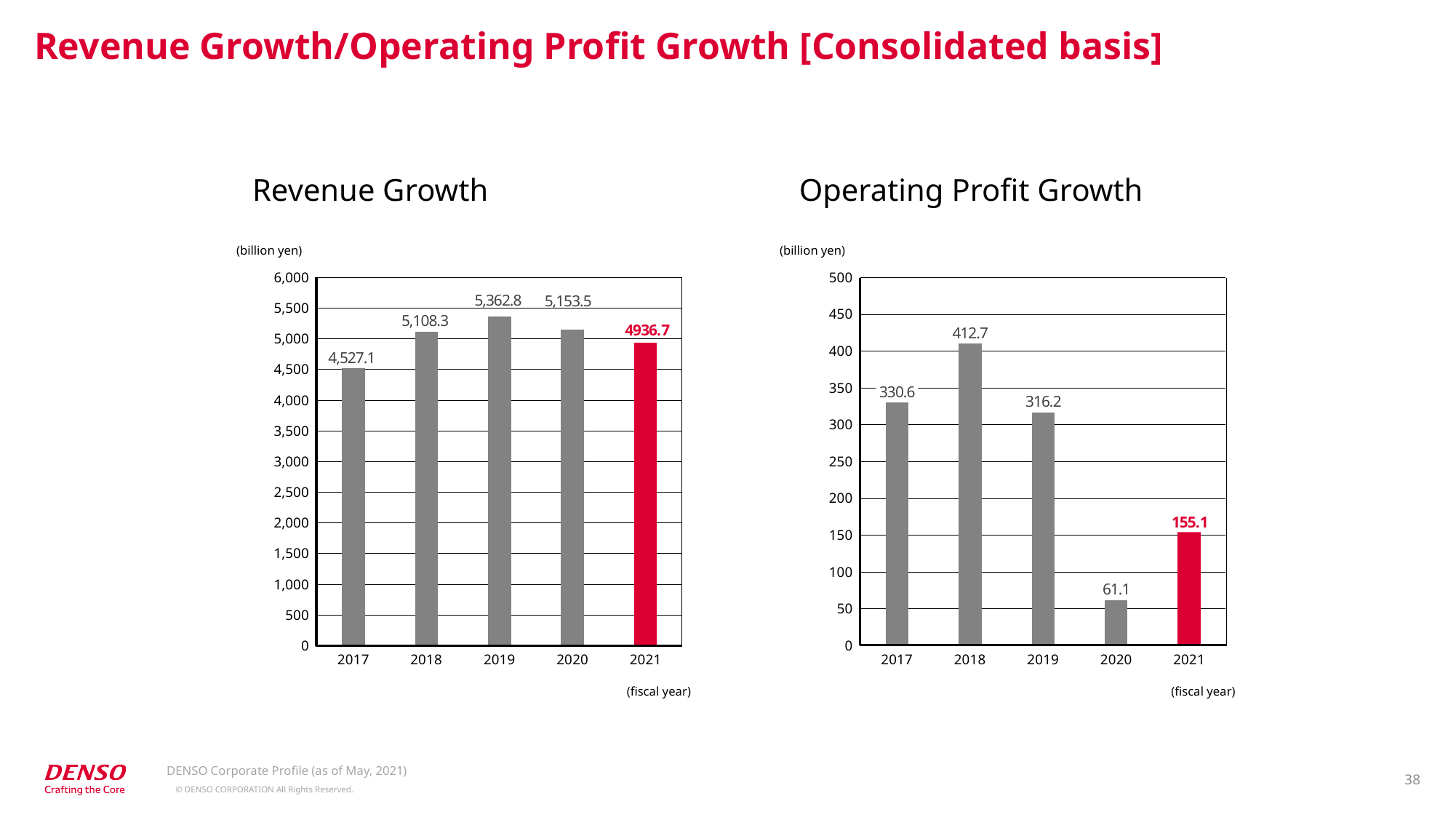
In the Revenue Growth chart, which fiscal year has the lowest revenue? 2017 In the Operating Profit Growth chart, what is the operating profit for fiscal year 2020? 61.1 How many fiscal years are shown in the Operating Profit Growth chart? 5 In the Revenue Growth chart, what is the difference between the revenue in 2019 and in 2017? 835.7 In the Operating Profit Growth chart, what unit is shown on the vertical axis? billion yen What kind of chart is the Revenue Growth chart? Bar chart In the Operating Profit Growth chart, what is the difference between the operating profit in 2018 and in 2020? 351.6 In the Revenue Growth chart, what is the revenue for fiscal year 2019? 5,362.8 In the Operating Profit Growth chart, which is larger, the operating profit in 2017 or in 2019? 2017 In the Operating Profit Growth chart, which fiscal year has the highest operating profit? 2018 In the Revenue Growth chart, is the value for 2021 greater or less than 5,000? less In the Revenue Growth chart, what is the revenue for fiscal year 2021? 4936.7